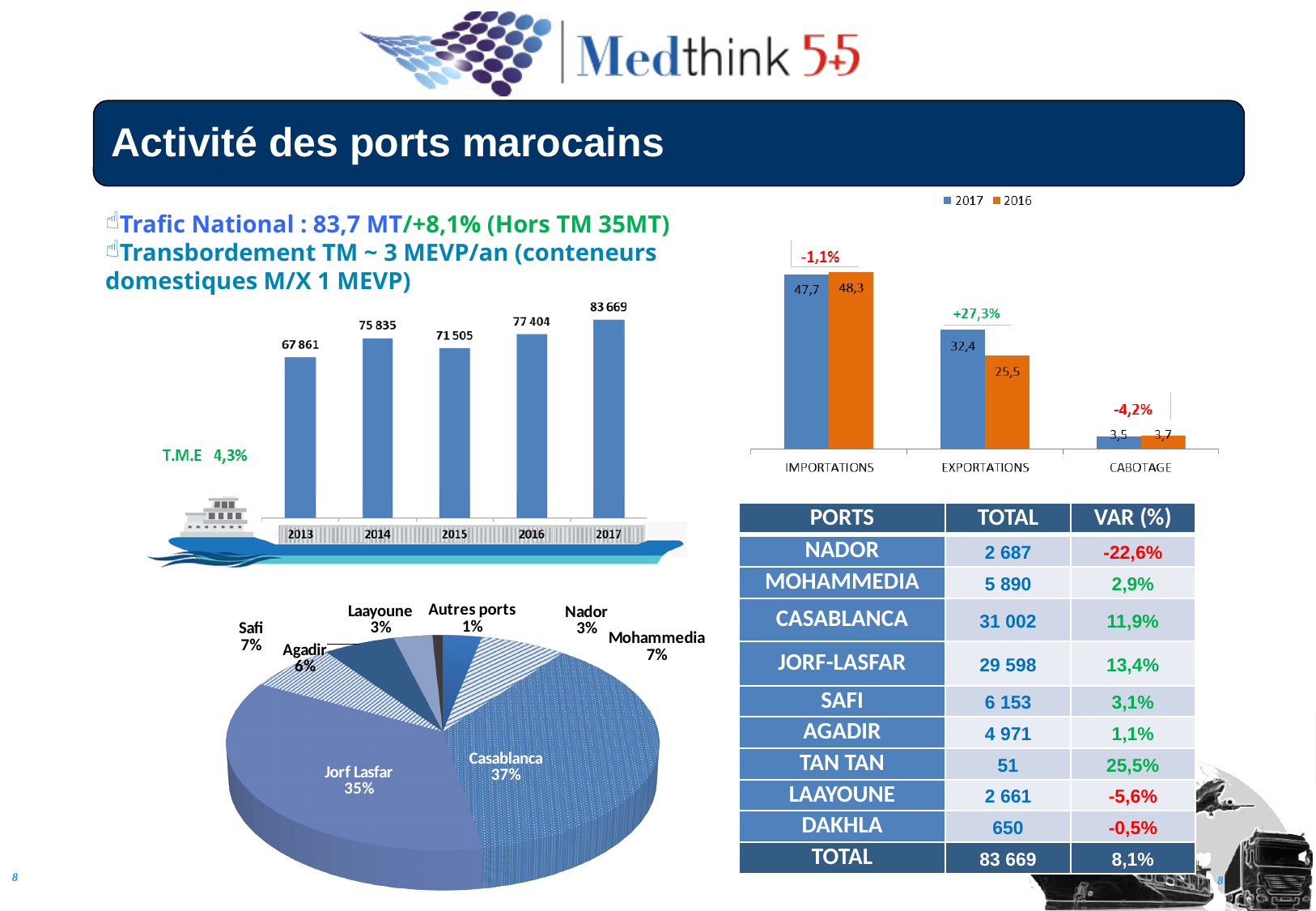
In the grouped bar chart at the top right, what is the 2016 value for IMPORTATIONS? 48,3 In the bar chart of yearly traffic on the left, which year has the lowest value? 2013 In the pie chart at the bottom left, which port has the largest share? Casablanca In the grouped bar chart at the top right, what is the difference between the 2017 and 2016 values for EXPORTATIONS? 6,9 In the bar chart of yearly traffic on the left, is the value for 2015 larger or smaller than the value for 2014? smaller In the grouped bar chart at the top right, how many series does the legend list? 2 In the bar chart of yearly traffic on the left, how many years are shown? 5 What kind of chart is shown at the bottom left of the slide? pie chart In the grouped bar chart at the top right, what is the 2017 value for EXPORTATIONS? 32,4 In the bar chart of yearly traffic on the left, what is the value for 2017? 83 669 In the bar chart of yearly traffic on the left, what is the difference between the 2017 and 2016 values? 6 265 In the pie chart at the bottom left, what share does Jorf Lasfar have? 35%